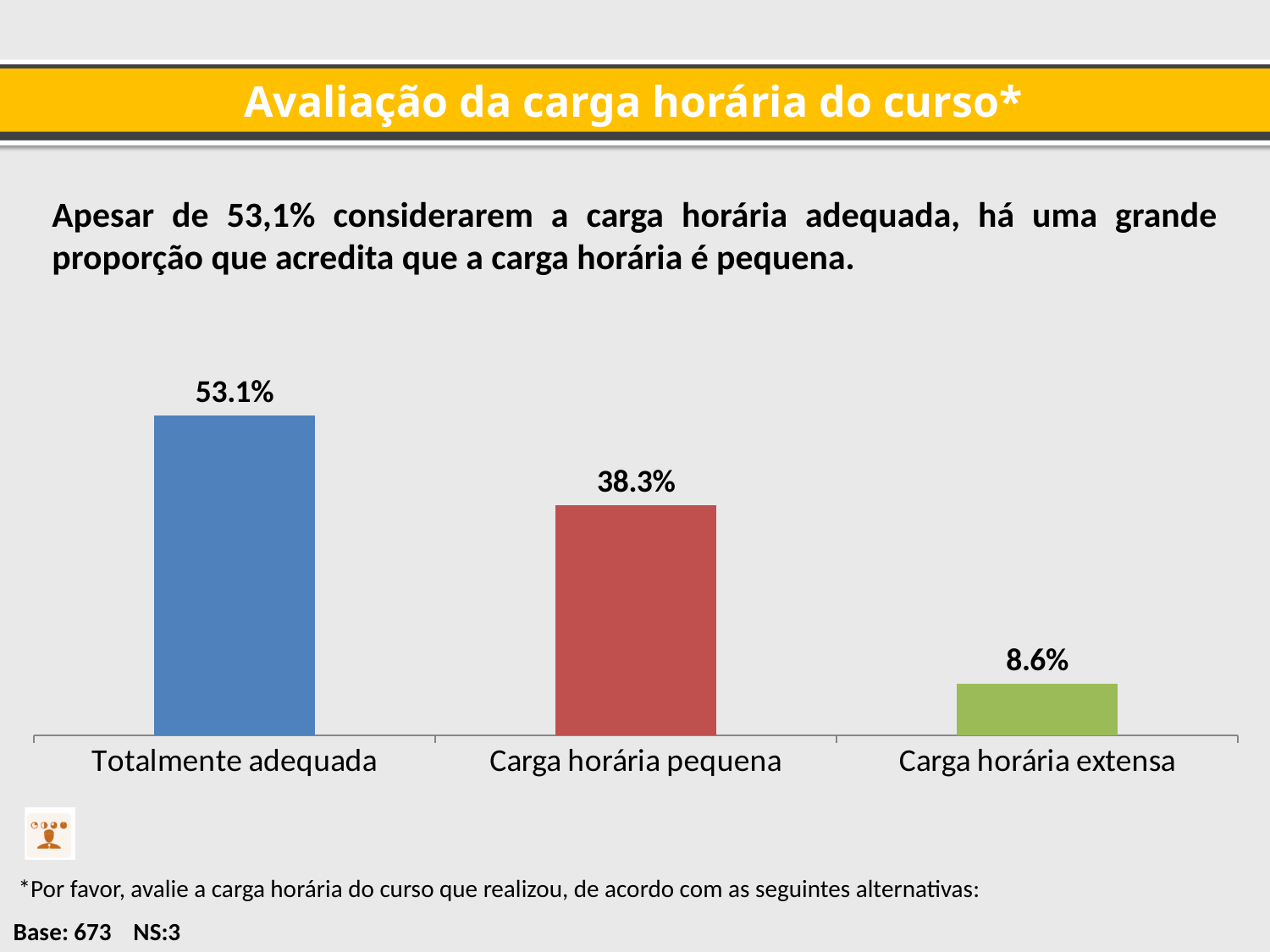
What is the value for Carga horária extensa? 8.6% What is the difference between the values for Totalmente adequada and Carga horária pequena? 14.8% What kind of chart is shown on the slide? Bar chart How many categories are shown in the chart? 3 What is the value for Carga horária pequena? 38.3% Do the values rise or fall from left to right along the x axis? Fall What is the difference between the values for Carga horária pequena and Carga horária extensa? 29.7% Which category has the highest value? Totalmente adequada Which category has the lowest value? Carga horária extensa What is the value for Totalmente adequada? 53.1% Which is larger, the value for Carga horária pequena or the value for Carga horária extensa? Carga horária pequena What is the title of the slide containing the chart? Avaliação da carga horária do curso*